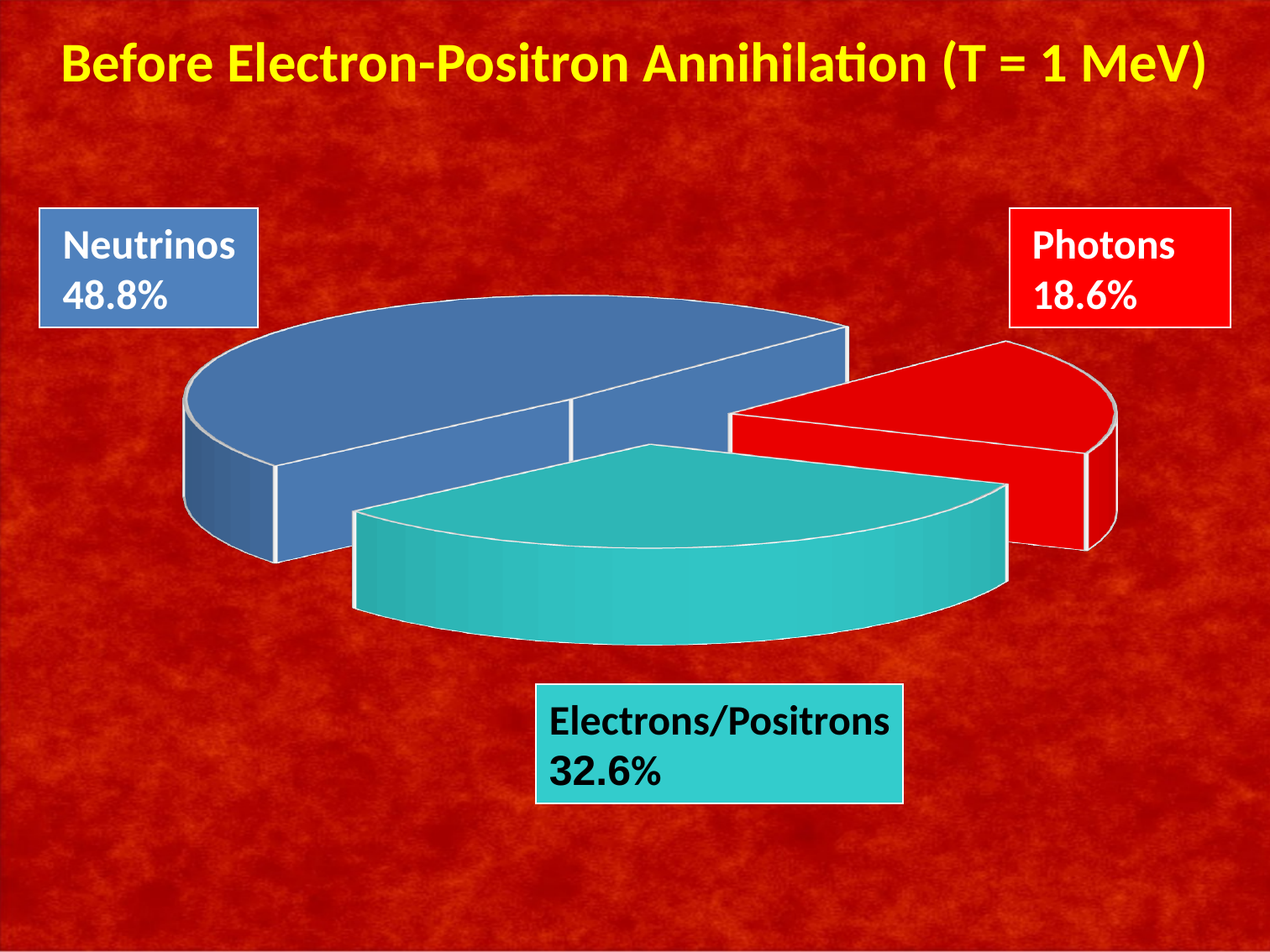
What share of the pie do Photons account for? 18.6% What share of the pie do Electrons/Positrons account for? 32.6% What is the difference between the Electrons/Positrons share and the Photons share? 14.0% What share of the pie do Neutrinos account for? 48.8% Which category has the smallest slice of the pie? Photons Which category has the largest slice of the pie? Neutrinos What is the title of the slide? Before Electron-Positron Annihilation (T = 1 MeV) What kind of chart is shown on the slide? Pie chart How many slices does the pie chart have? 3 Which is larger, the Electrons/Positrons share or the Photons share? Electrons/Positrons What is the difference between the Neutrinos share and the Photons share? 30.2% What colour is the Photons slice? Red